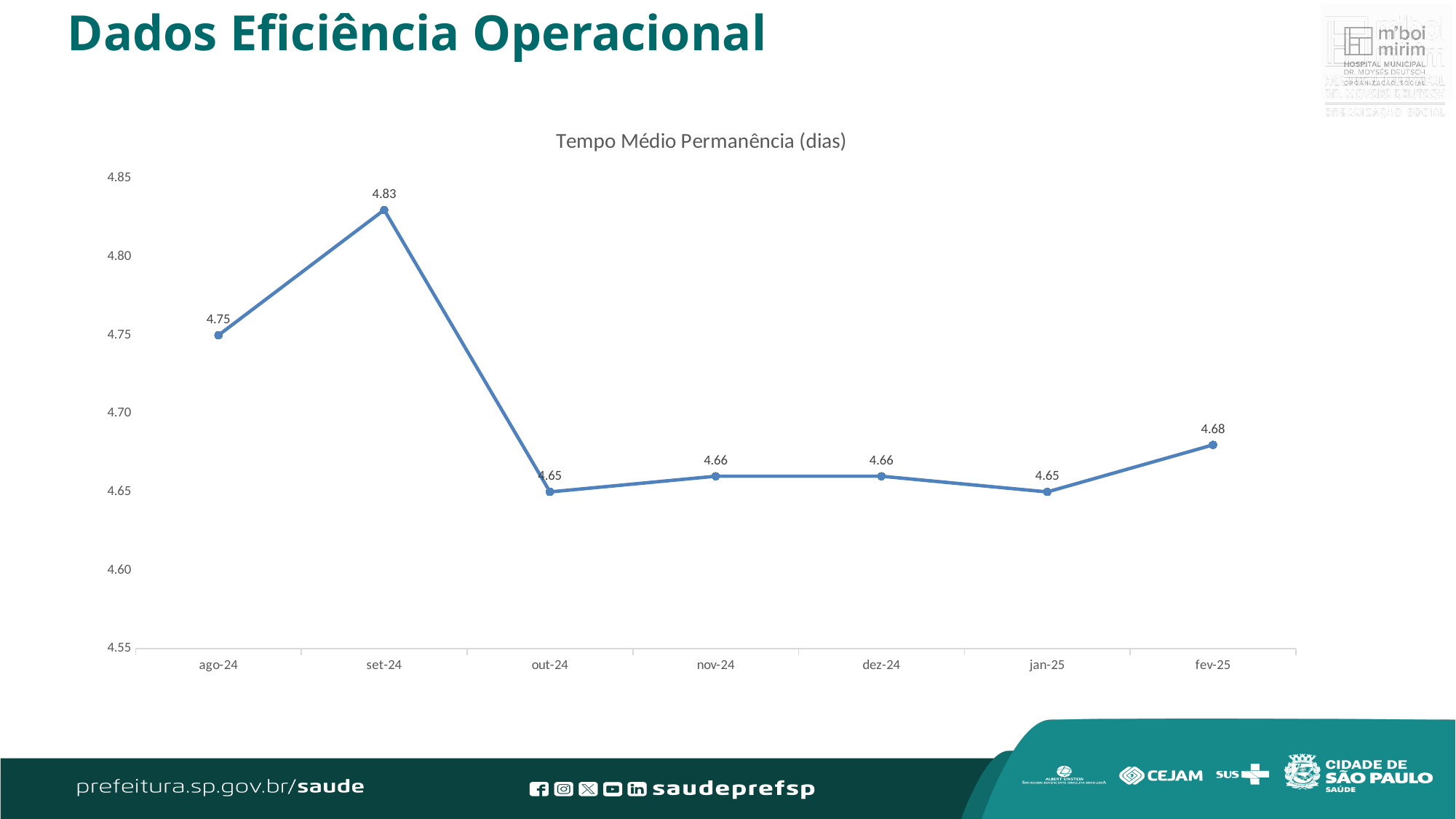
Which is larger, the value for ago-24 or the value for dez-24? ago-24 What is the difference between the values for ago-24 and fev-25? 0.07 How many months are plotted on the chart? 7 What is the title of the chart? Tempo Médio Permanência (dias) What is the value for set-24? 4.83 What is the value for fev-25? 4.68 What is the value for jan-25? 4.65 Is the value for set-24 greater or less than 4.80? greater What kind of chart is shown? line chart What is the difference between the values for set-24 and out-24? 0.18 Which month has the highest value? set-24 What is the value for ago-24? 4.75